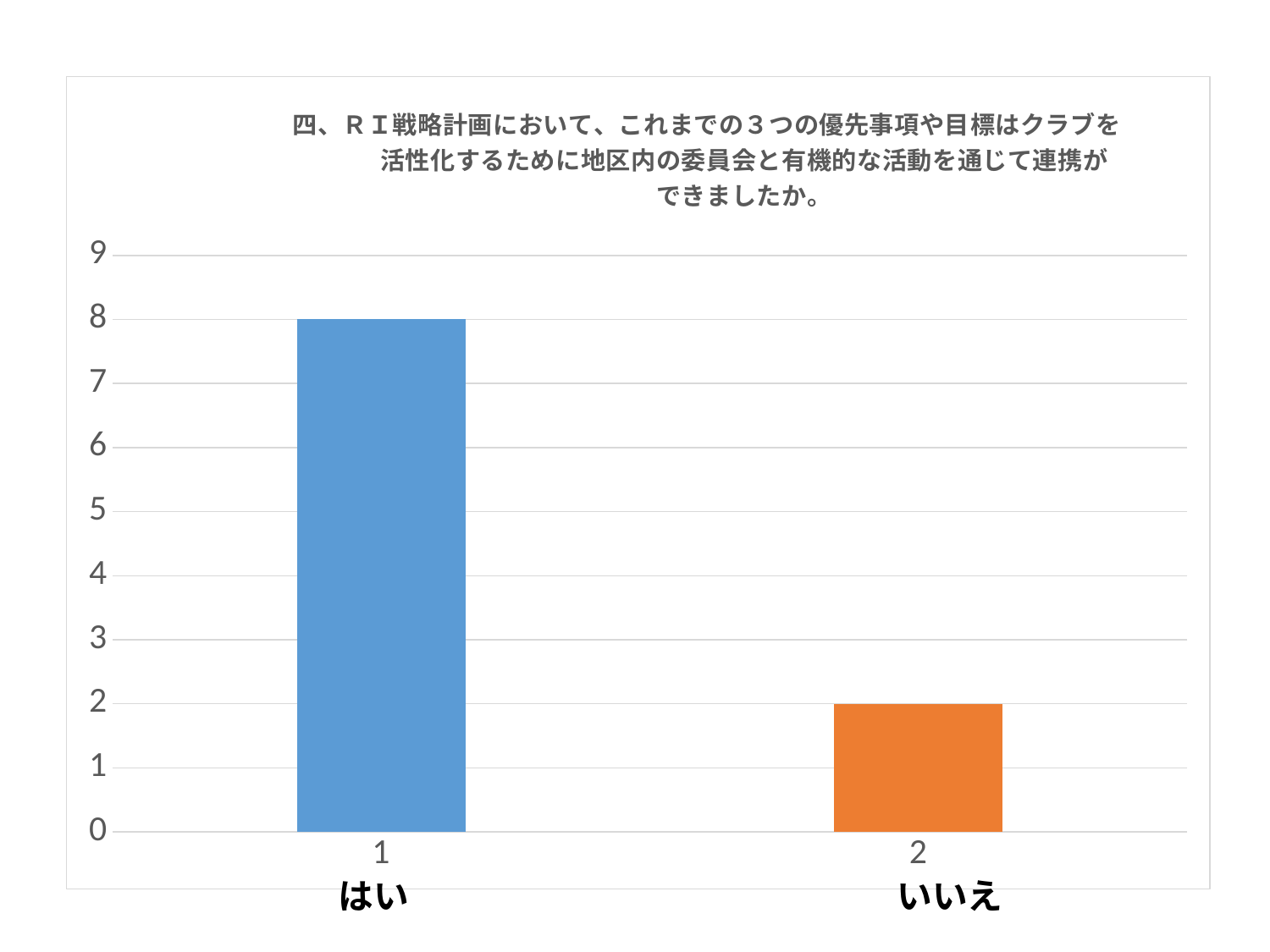
What is the value for category 1 (はい)? 8 Which category has the highest value? 1 (はい) Do the values rise or fall from category 1 to category 2? fall Is the value for はい greater or less than 5? greater What is the difference between the values for はい and いいえ? 6 Is the value for いいえ greater or less than 4? less What is the value for category 2 (いいえ)? 2 Which is larger, the value for はい or the value for いいえ? はい What colour is the bar for いいえ? orange Which category has the lowest value? 2 (いいえ) What kind of chart is shown on the slide? bar chart How many categories are shown on the x axis? 2